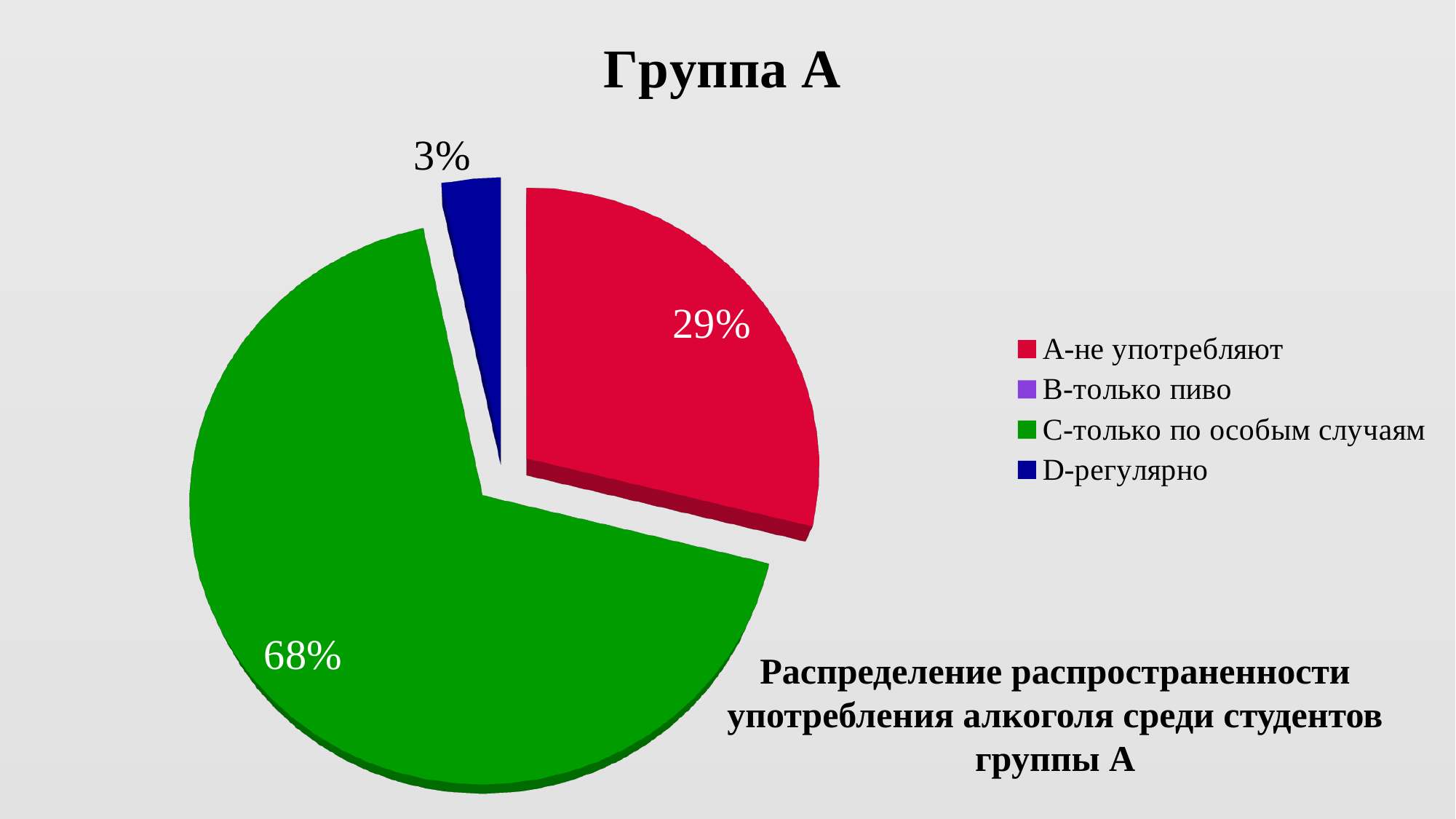
Which labelled slice of the pie is the smallest? D-регулярно What share of the pie does the slice for D-регулярно take? 3% Which category has the largest slice of the pie? C-только по особым случаям What colour is the slice for C-только по особым случаям? green What share of the pie does the slice for A-не употребляют take? 29% What is the difference in percentage points between the slices for C-только по особым случаям and A-не употребляют? 39 How many entries does the legend list? 4 What share of the pie does the slice for C-только по особым случаям take? 68% How many slices with percentage labels are visible in the pie? 3 What is the title of the chart? Группа А Which is larger, the slice for A-не употребляют or the slice for D-регулярно? A-не употребляют What kind of chart is shown on the slide? pie chart